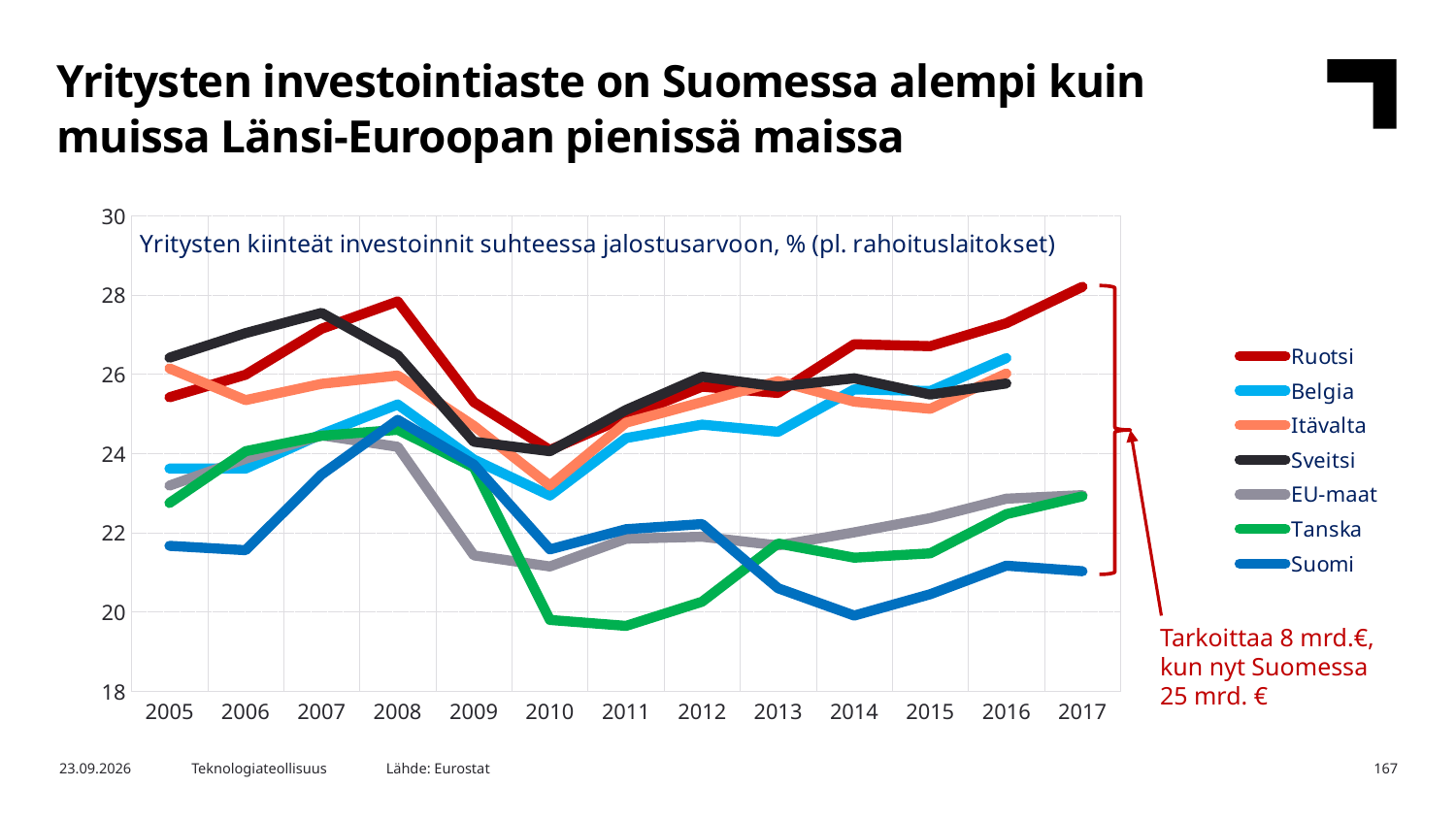
How many series does the legend list? 7 Is the value for EU-maat in 2010 greater or less than 22? less Which series has the lowest value in 2005? Suomi Is the value for Sveitsi in 2007 greater or less than 26? greater Does the value for Ruotsi rise or fall from 2013 to 2017? rise In 2017, which is larger: the value for Tanska or the value for Suomi? Tanska How many years are shown on the x axis? 13 Which series has the highest value in 2017? Ruotsi Which series has the lowest value in 2011? Tanska Which series has the lowest value in 2017? Suomi What kind of chart is shown on the slide? line chart Is the value for Suomi in 2017 greater or less than 22? less